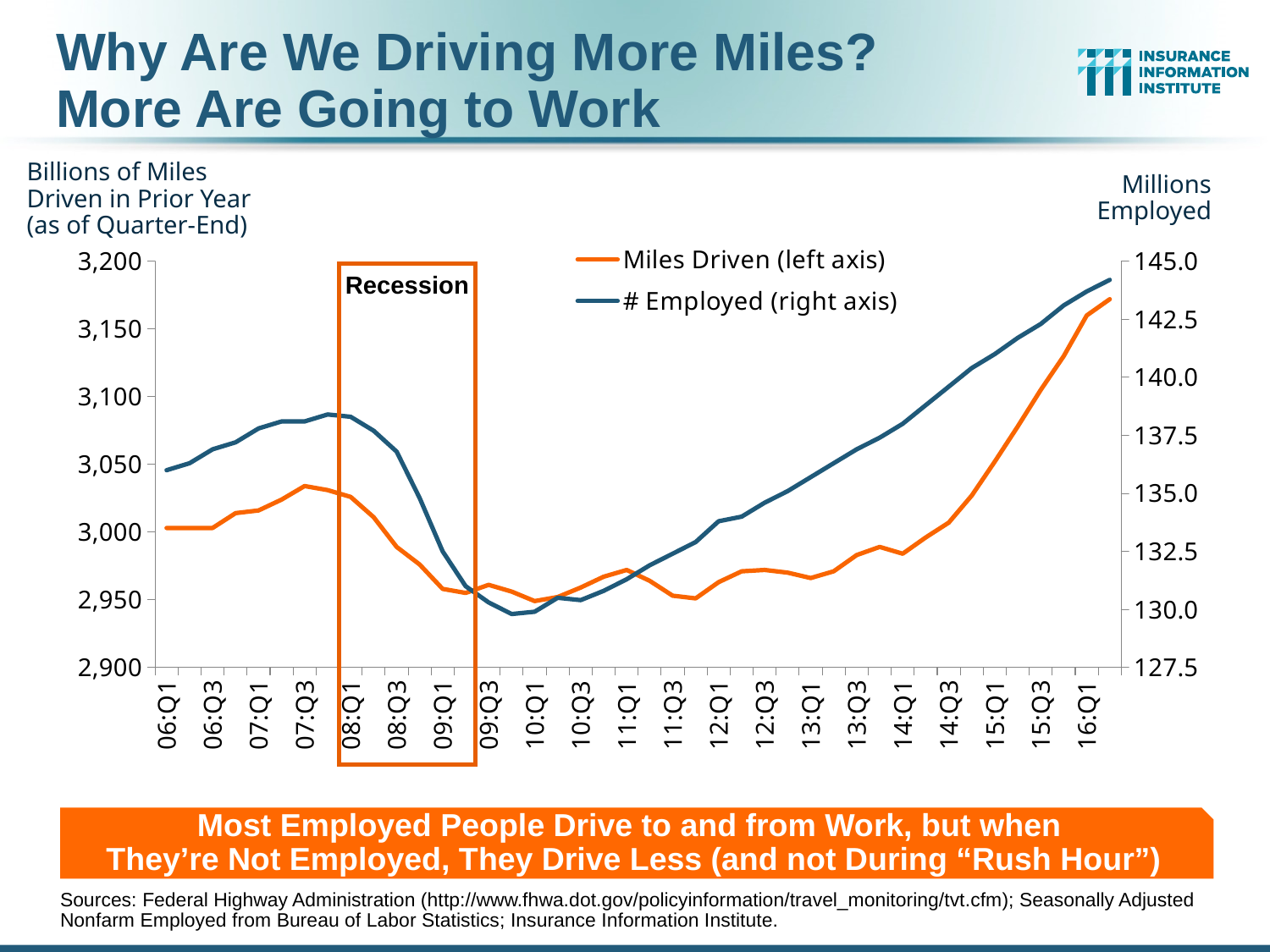
Does the # Employed line rise or fall between 08:Q1 and 09:Q3? fall Does the Miles Driven line rise or fall between 13:Q1 and 16:Q1? rise What label is written inside the orange box drawn over the 2008–2009 period? Recession Is the value for # Employed at 06:Q1 greater or less than 135.0? greater How many series does the legend list? 2 How many quarter labels are shown along the x axis? 21 Which series is plotted against the right axis according to the legend? # Employed What kind of chart is shown on the slide? line chart Is the value for Miles Driven at 07:Q3 greater or less than 3,000? greater Is the value for Miles Driven at 09:Q1 greater or less than 3,000? less Which is higher for Miles Driven: the value at 07:Q3 or the value at 09:Q1? 07:Q3